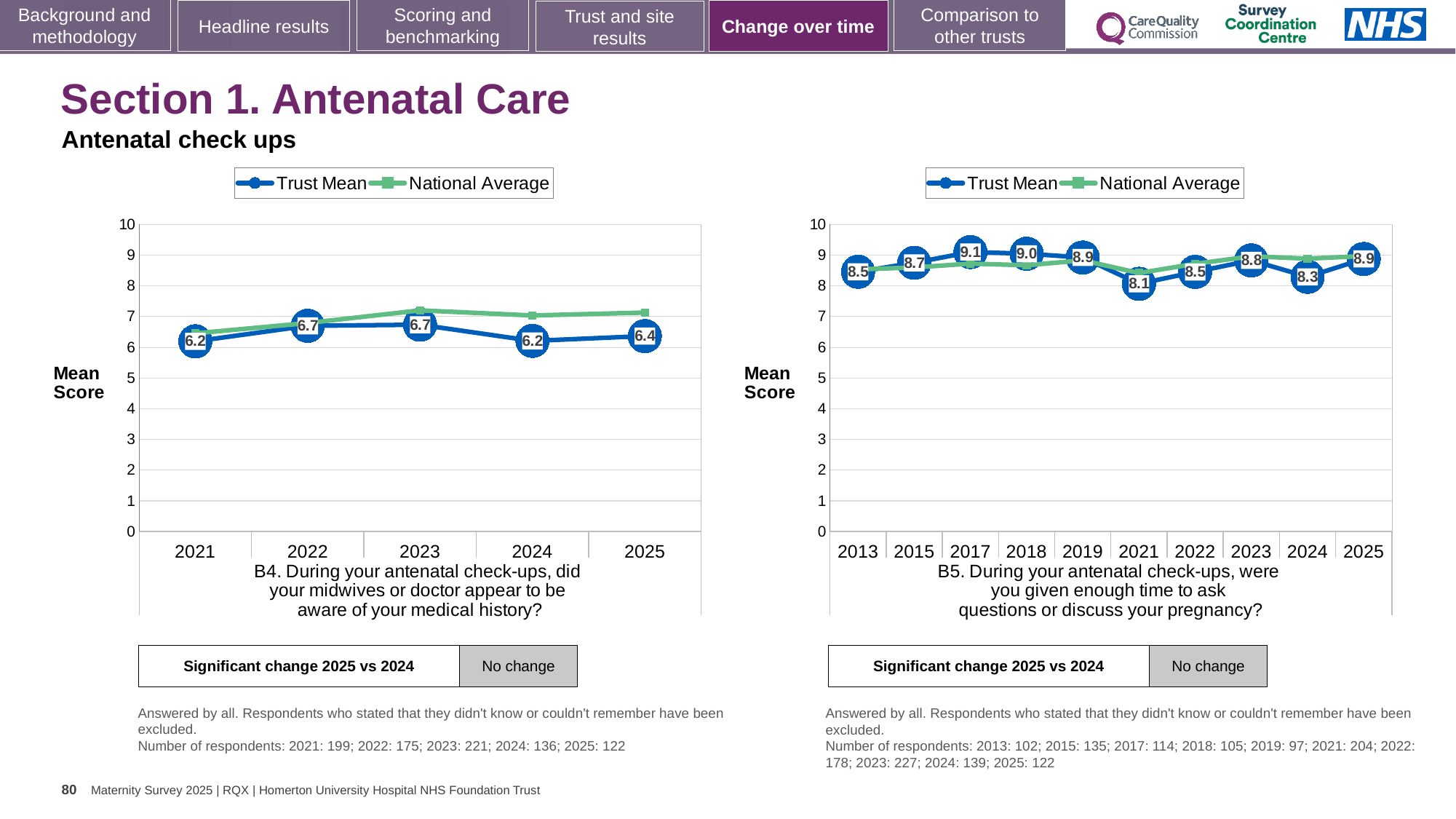
In the B5 chart on the right, what is the difference between the Trust Mean in 2017 and in 2021? 1.0 In the B4 chart on the left, what is the Trust Mean for 2025? 6.4 What type of chart is the B5 chart on the right? Line chart In the B5 chart on the right, which year has the highest Trust Mean? 2017 In the B5 chart on the right, what is the Trust Mean for 2018? 9.0 In the B4 chart on the left, is the National Average for 2021 greater or less than 7? less In the B4 chart on the left, does the Trust Mean rise or fall from 2023 to 2024? Fall In the B4 chart on the left, is the Trust Mean higher in 2022 or in 2024? 2022 How many years are shown on the x axis of the B5 chart on the right? 10 In the B5 chart on the right, which year has the lowest Trust Mean? 2021 How many series does the legend of the B4 chart on the left list? 2 In the B4 chart on the left, what is the Trust Mean for 2023? 6.7